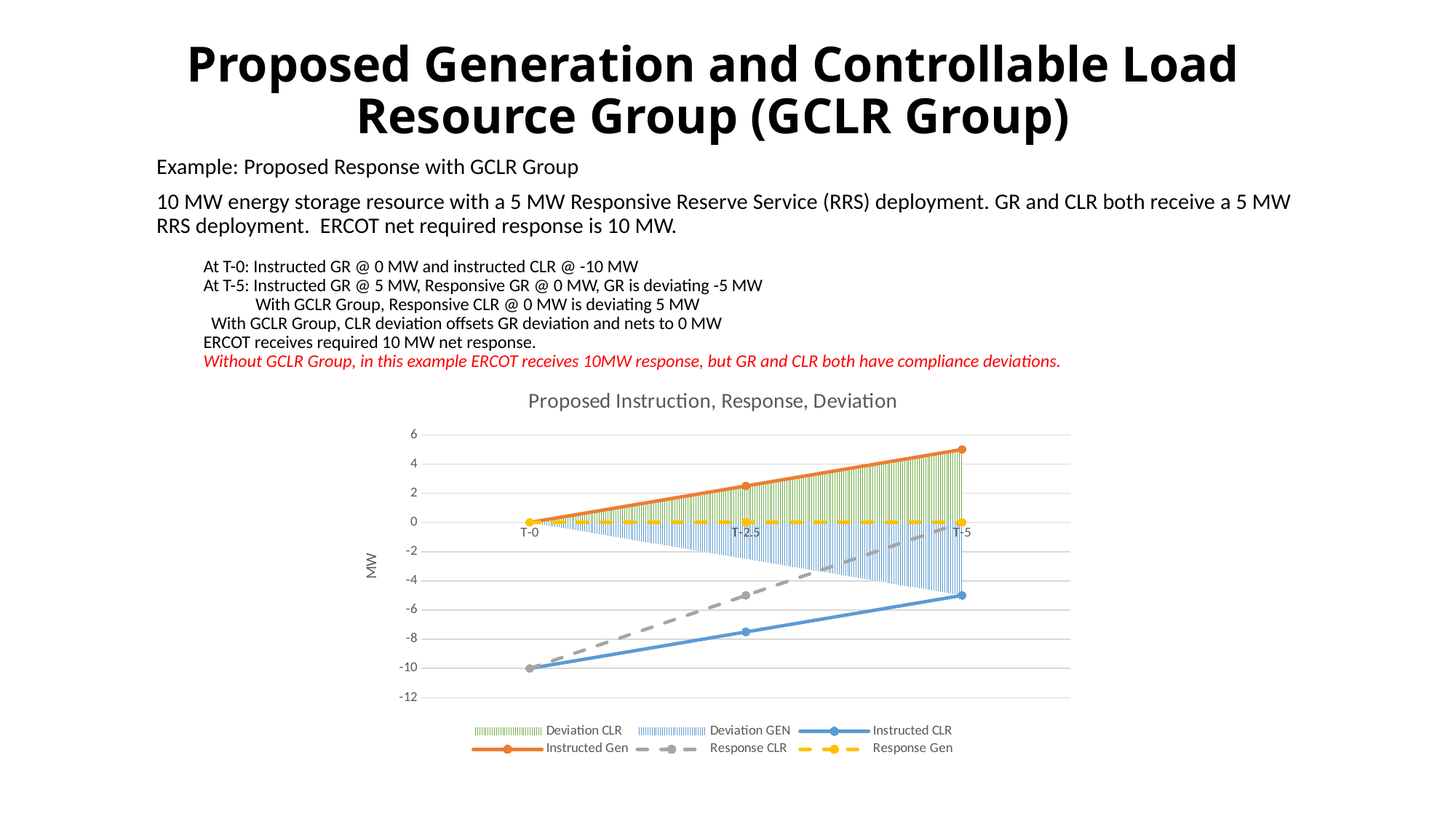
Does the Instructed CLR line rise or fall from T-0 to T-5? rise Is the value for Instructed CLR at T-2.5 greater or less than -6? less What is the label on the vertical axis of the chart? MW How many time points are shown on the x axis of the chart? 3 What is the value of Response Gen at T-2.5? 0 What is the value of Instructed Gen at T-0? 0 What is the title of the chart? Proposed Instruction, Response, Deviation How many series does the chart legend list? 6 What kind of chart is shown on the slide? combination area and line chart Is the value for Instructed Gen at T-5 greater or less than 4? greater What is the value of Instructed CLR at T-0? -10 What is the value of Response CLR at T-5? 0